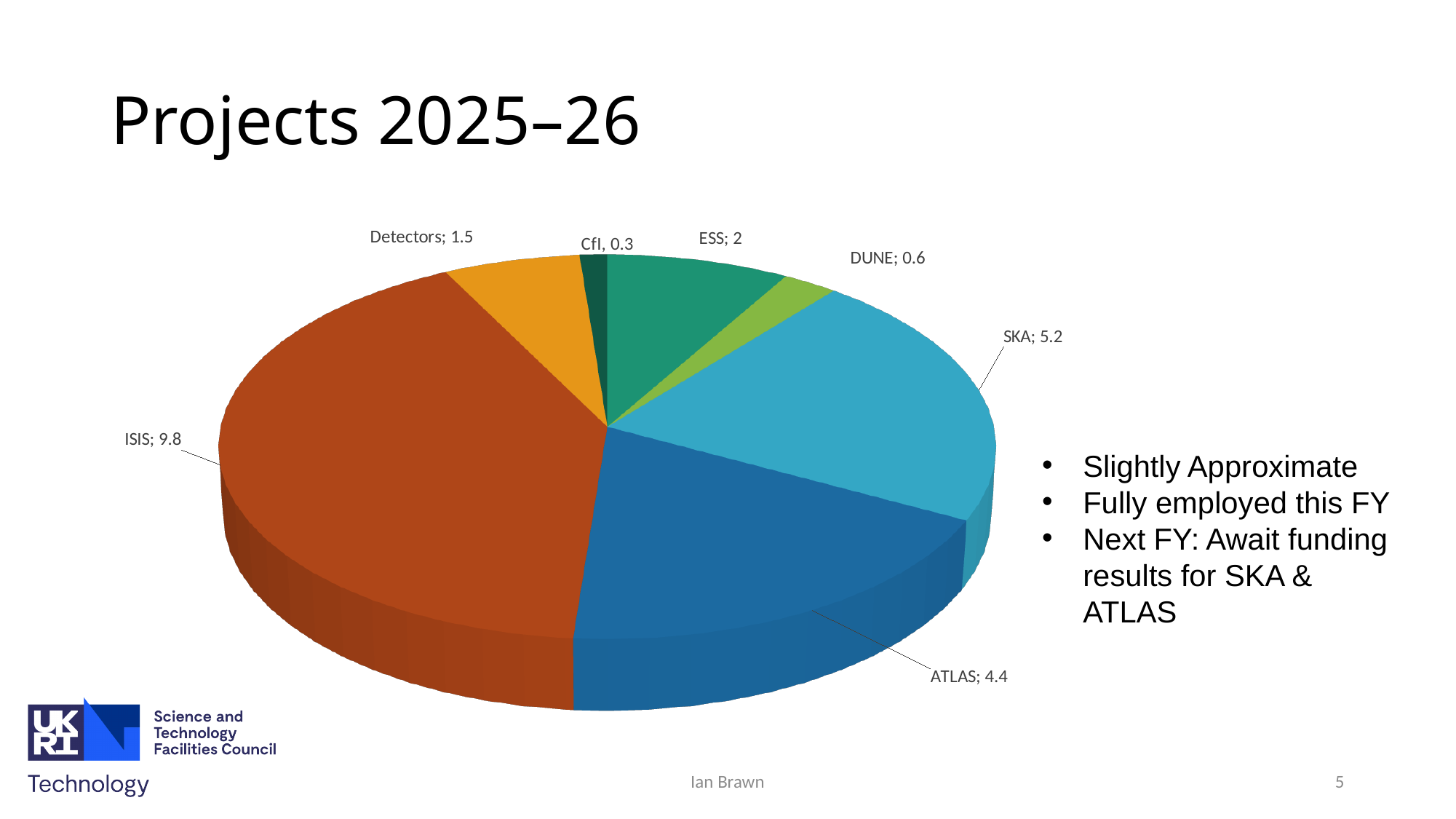
Which project has the largest slice of the pie? ISIS What is the title of the slide containing the pie chart? Projects 2025–26 What is the value for CfI? 0.3 How many slices does the pie chart have? 7 Which project has the smallest slice of the pie? CfI What is the value for ISIS? 9.8 Which is larger, the value for ESS or the value for Detectors? ESS What is the difference between the values for ISIS and SKA? 4.6 What is the value for SKA? 5.2 What is the value for DUNE? 0.6 What kind of chart is shown on the slide? pie chart What is the difference between the values for SKA and ATLAS? 0.8